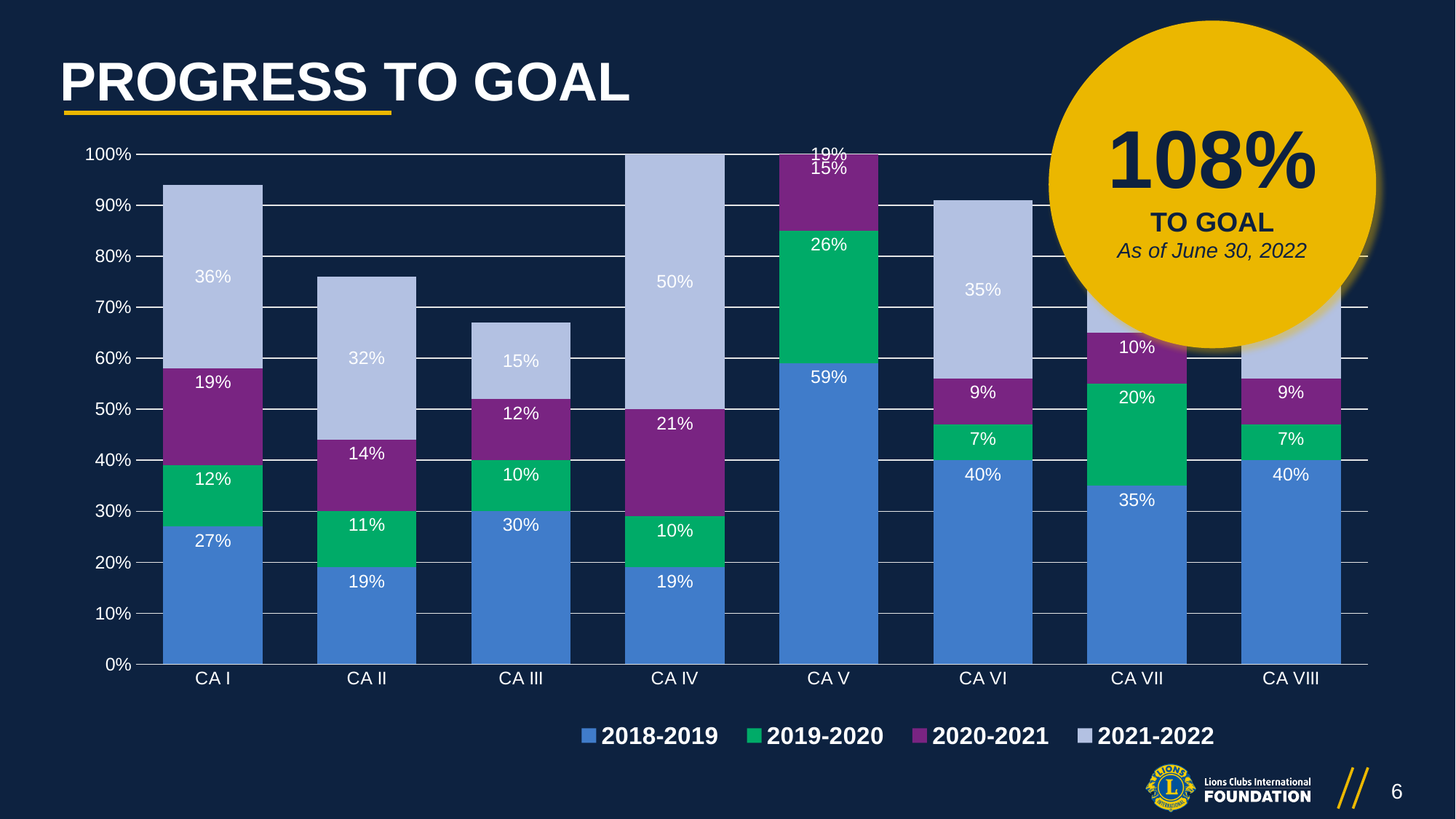
How many categories (constitutional areas) are shown on the x axis? 8 How many series does the legend list? 4 What is the 2021-2022 value for CA IV? 50% What is the 2018-2019 value for CA I? 27% What overall progress-to-goal percentage is shown in the yellow circle? 108% What kind of chart is shown on the slide? Stacked bar chart What is the 2021-2022 value for CA VI? 35% Which category has the highest 2020-2021 value? CA IV What is the difference between the 2021-2022 values for CA I and CA II? 4 percentage points What is the total of the stacked bar for CA I? 94% Which is larger, the 2018-2019 value for CA III or for CA VII? CA VII Which category has the highest 2018-2019 value? CA V